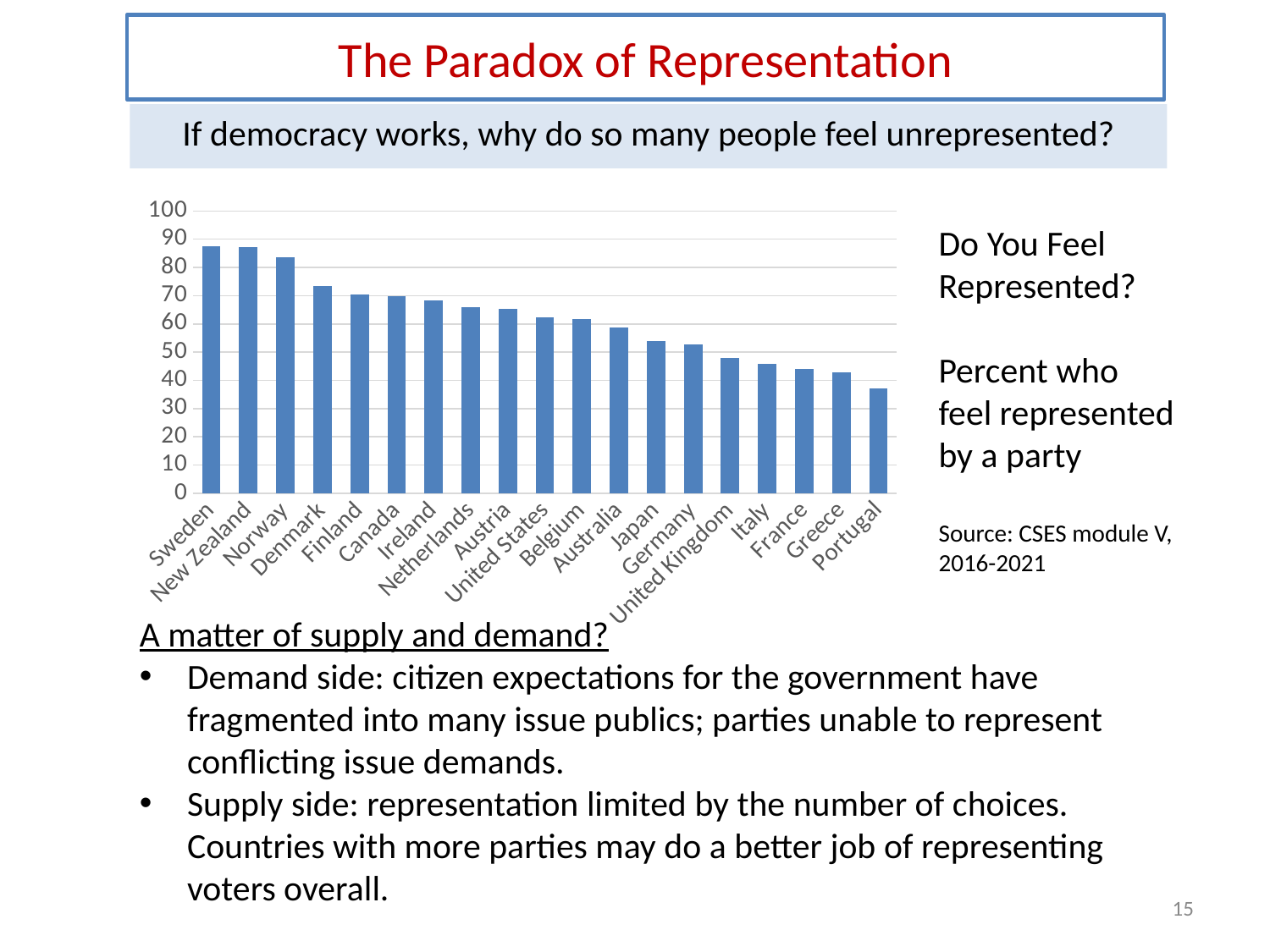
How many countries are shown in the chart? 19 Is the value for Sweden greater or less than 80? greater Do the values rise or fall moving from left to right across the countries? Fall Is the value for France greater or less than 50? less Is the value for Austria greater or less than 60? greater According to the text beside the chart, what source is the data from? CSES module V, 2016-2021 Which has a higher value, Norway or Denmark? Norway What kind of chart is shown on the slide? Bar chart Which country has the lowest percentage of people who feel represented by a party? Portugal